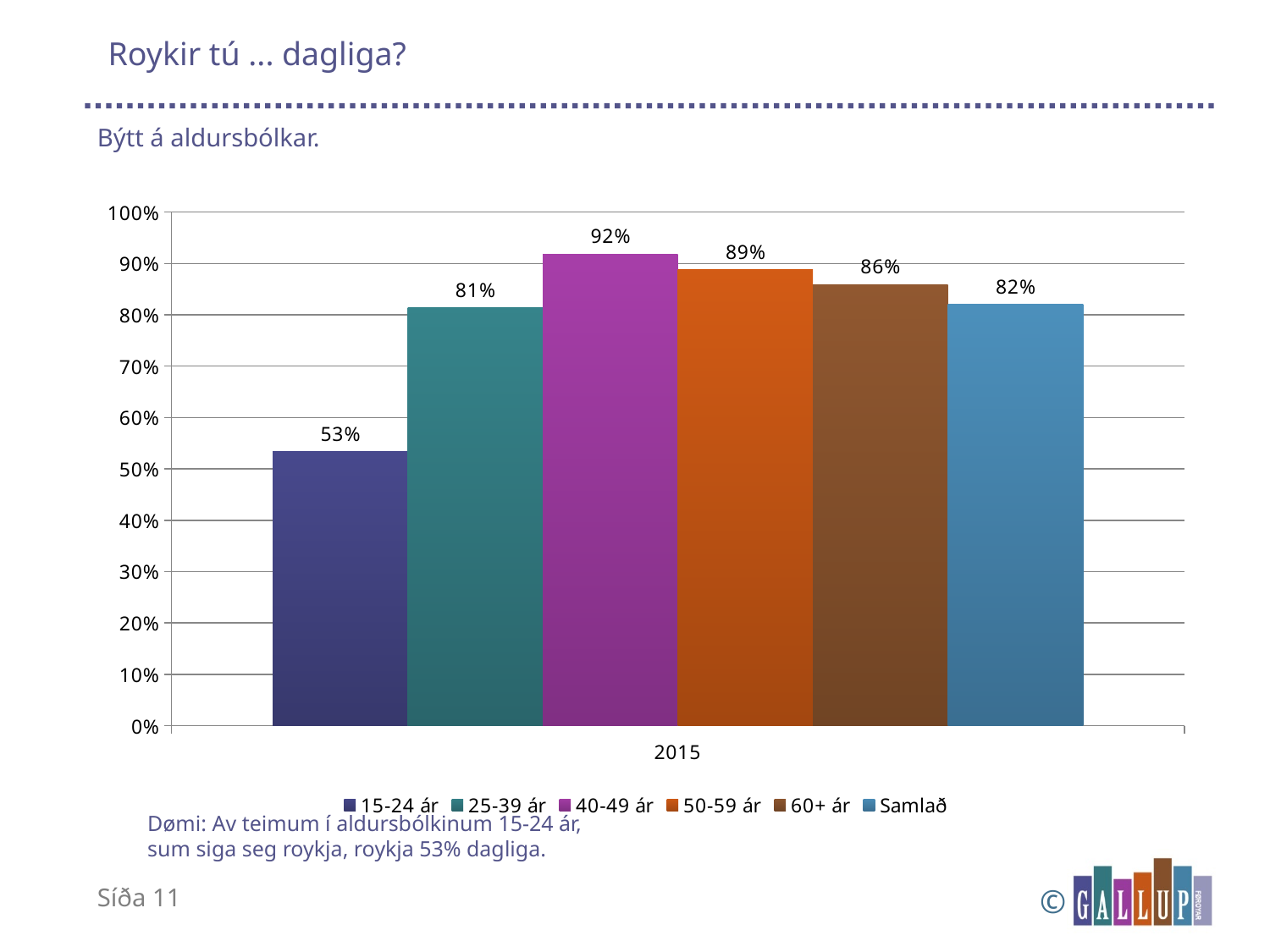
What is the value for the 40-49 ár series? 92% Which is larger, the value for 25-39 ár or the value for 60+ ár? 60+ ár Which series has the lowest value? 15-24 ár What is the value for the 15-24 ár series? 53% What is the category label shown on the x axis? 2015 Is the value for 15-24 ár greater or less than 60%? less What is the difference between the values for 40-49 ár and 15-24 ár? 39% What is the value for Samlað? 82% What is the difference between the values for 50-59 ár and 60+ ár? 3% What kind of chart is shown on the slide? bar chart How many series does the legend list? 6 Which series has the highest value? 40-49 ár